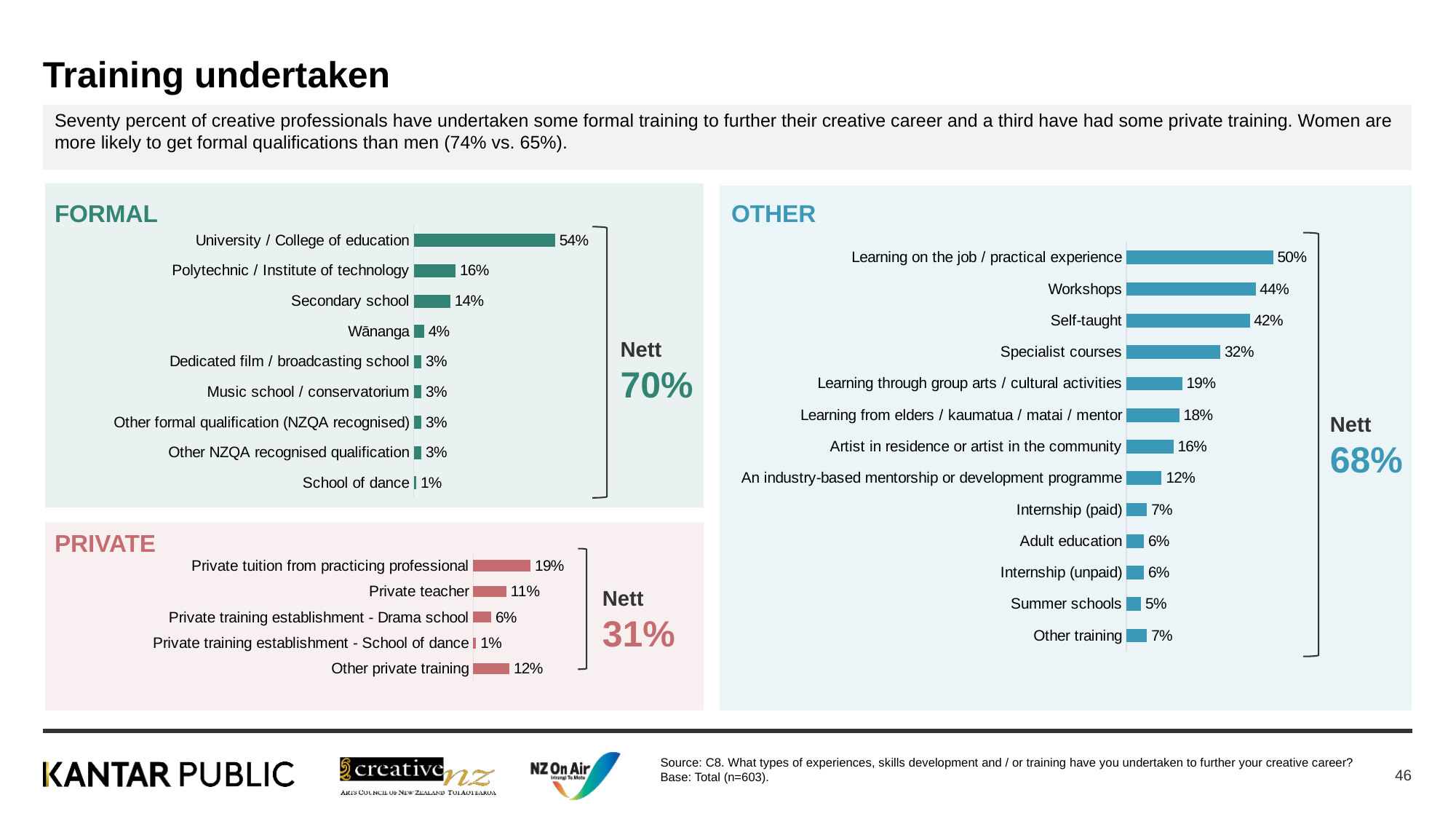
How many categories are shown in the PRIVATE chart? 5 In the OTHER chart, what is the value for Self-taught? 42% In the OTHER chart, which category has the highest value? Learning on the job / practical experience In the FORMAL chart, what is the difference between Polytechnic / Institute of technology and Secondary school? 2% In the PRIVATE chart, what is the value for Private teacher? 11% What is the Nett value shown for the OTHER chart? 68% In the OTHER chart, what is the difference between Workshops and Specialist courses? 12% How many categories are shown in the OTHER chart? 13 In the FORMAL chart, what is the value for University / College of education? 54% In the FORMAL chart, which category has the lowest value? School of dance What kind of chart is the FORMAL chart? Bar chart In the PRIVATE chart, which is larger: Private tuition from practicing professional or Other private training? Private tuition from practicing professional